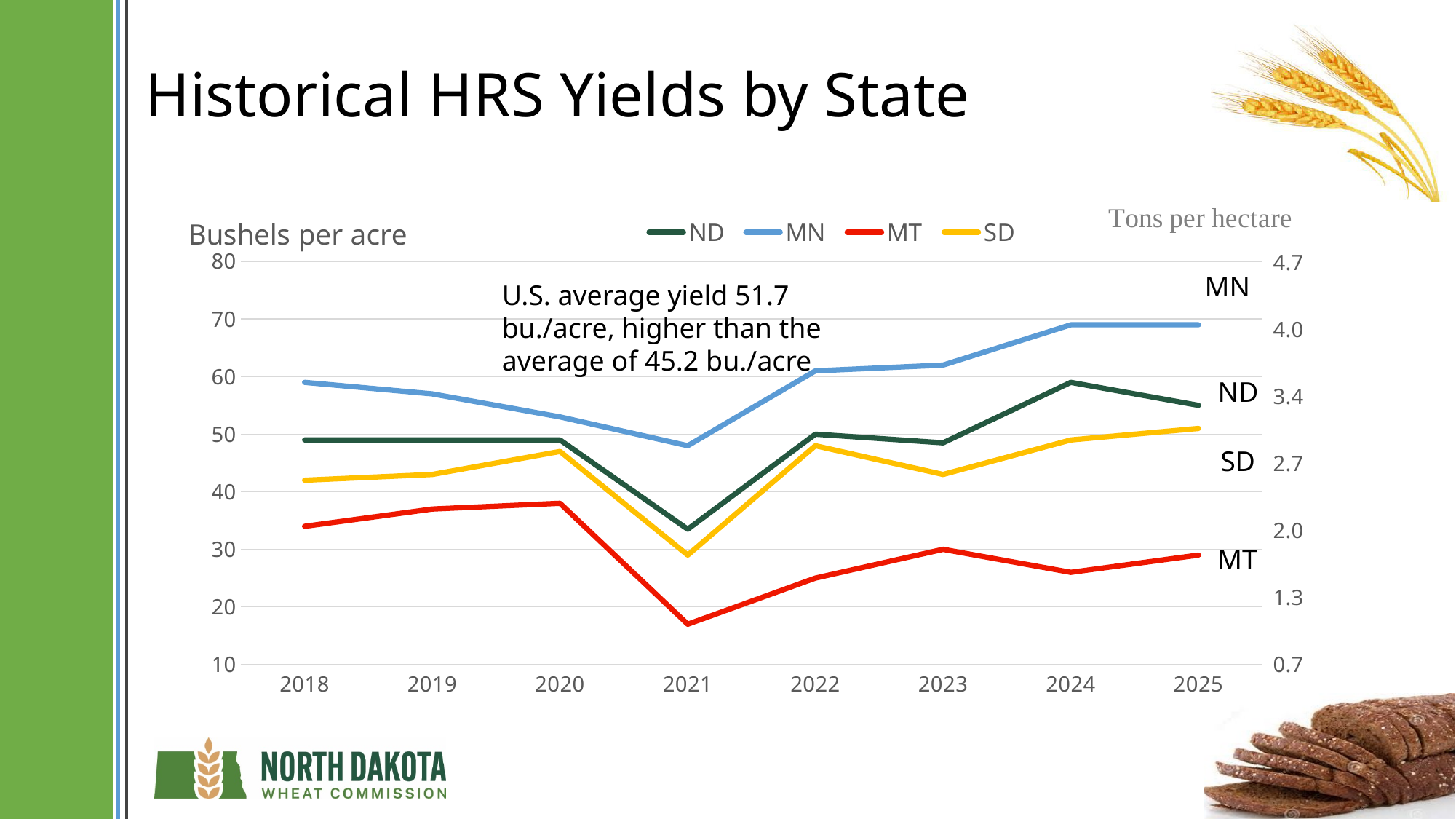
Which state has the highest yield in 2025? MN Which state has the lowest yield in 2021? MT Is the value for MT in 2021 greater or less than 20? less How many years are shown along the x axis? 8 Is the value for ND in 2024 greater or less than 50? greater What kind of chart is shown on the slide? line chart What unit is labelled on the left axis of the chart? Bushels per acre How many series does the legend list? 4 In 2024, which is larger, the value for ND or the value for SD? ND What is the title of the chart? Historical HRS Yields by State Is the value for MN in 2025 greater or less than 60? greater Does the MN line rise or fall from 2021 to 2024? rise